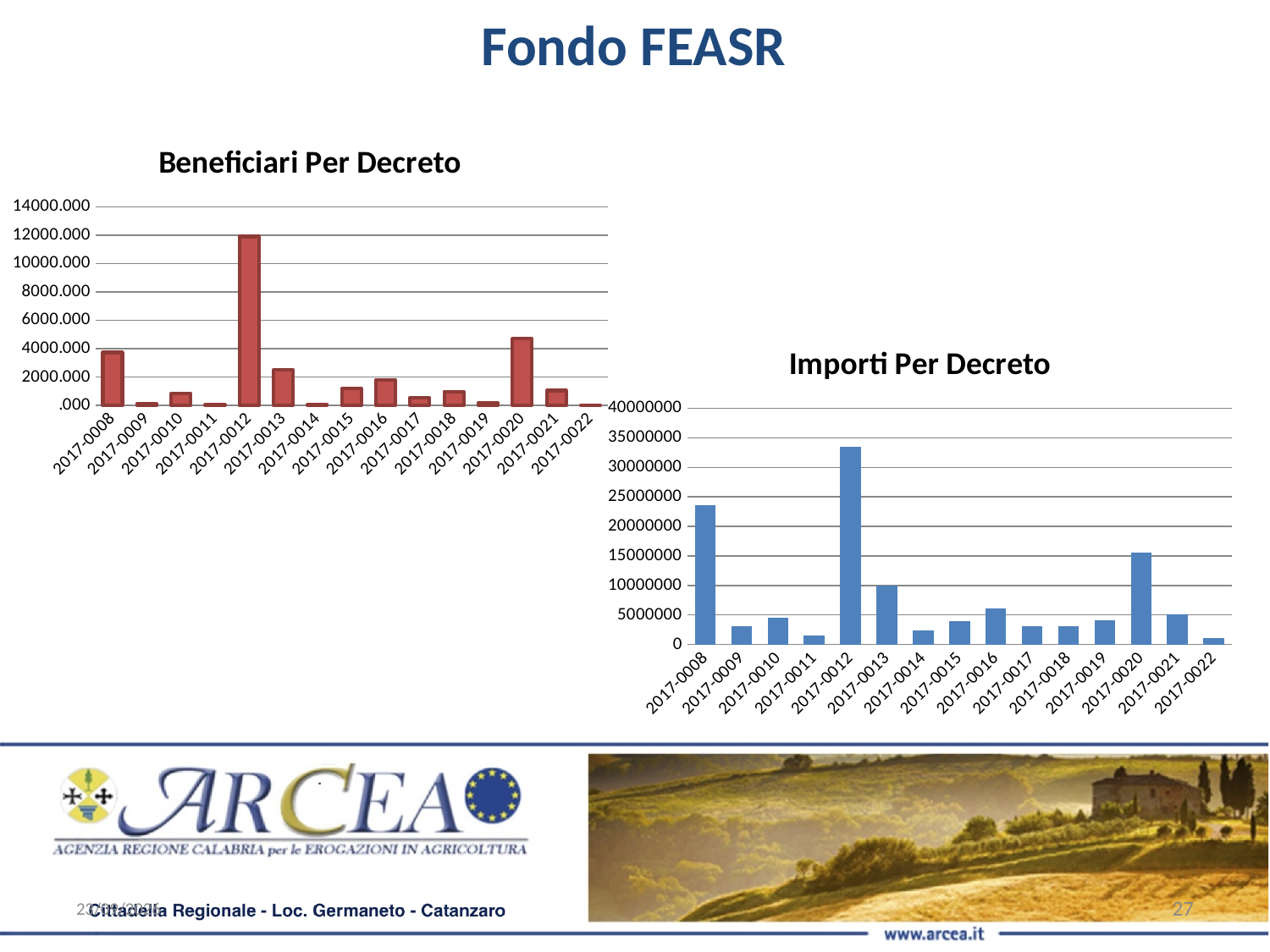
In the 'Importi Per Decreto' chart, which decree has the highest value? 2017-0012 In the 'Importi Per Decreto' chart, is the value for 2017-0022 greater or less than 5000000? less In the 'Importi Per Decreto' chart, is the value for 2017-0008 greater or less than 20000000? greater What kind of chart is 'Beneficiari Per Decreto'? bar chart In the 'Beneficiari Per Decreto' chart, which is larger, the value for 2017-0020 or the value for 2017-0013? 2017-0020 What colour are the bars in the 'Importi Per Decreto' chart? blue In the 'Beneficiari Per Decreto' chart, which decree has the highest value? 2017-0012 In the 'Beneficiari Per Decreto' chart, is the value for 2017-0012 greater or less than 10000.000? greater In the 'Importi Per Decreto' chart, which is larger, the value for 2017-0008 or the value for 2017-0020? 2017-0008 How many decrees are shown on the x axis of the 'Importi Per Decreto' chart? 15